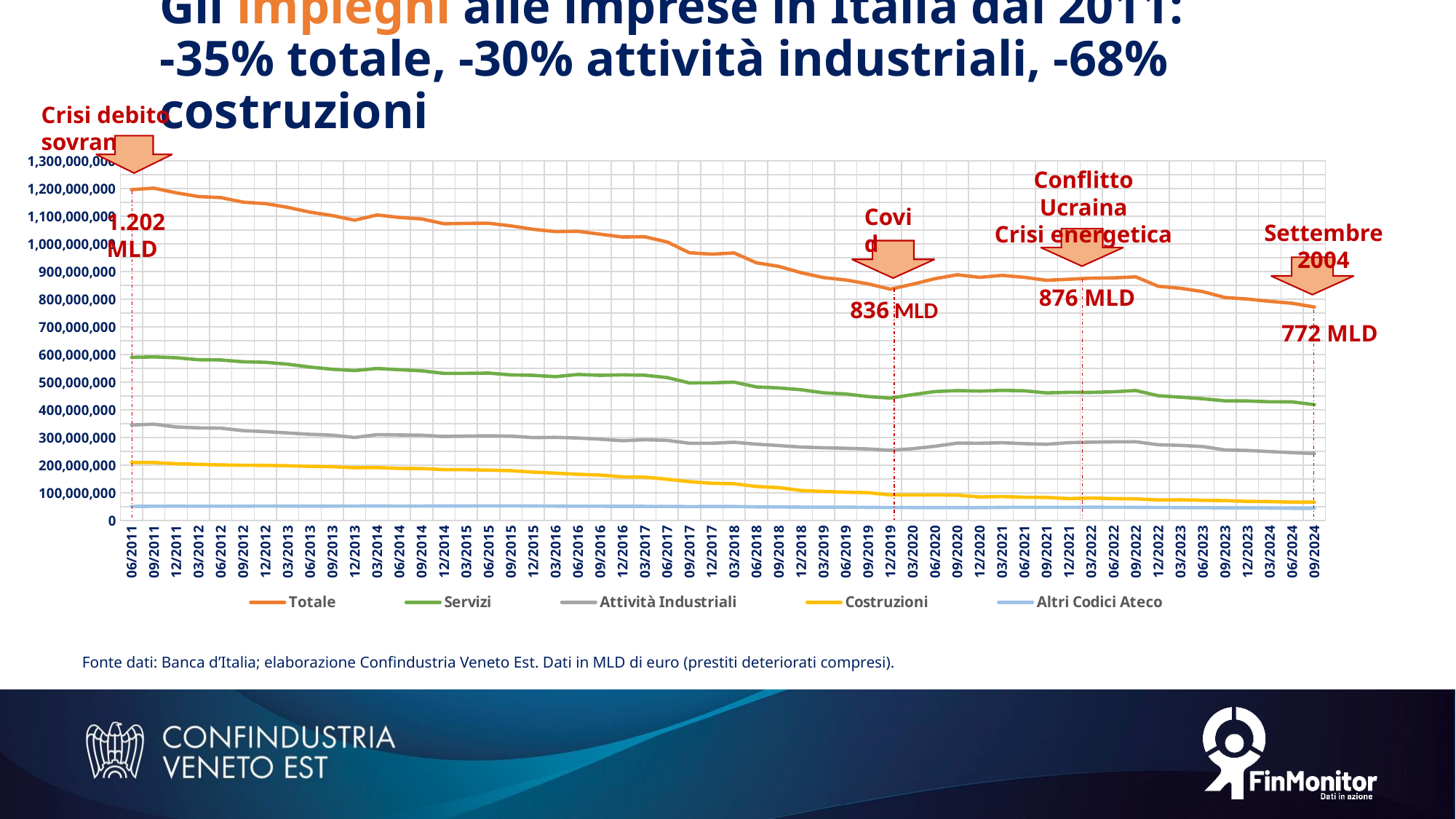
What value is labelled for the Totale series at 09/2024? 772 MLD What kind of chart is shown on the slide? line chart Is the value for Costruzioni at 09/2024 greater or less than 100,000,000? less How many series does the legend list? 5 Does the Totale series rise or fall from 06/2011 to 09/2024? fall Which series is drawn in orange? Totale Is the value for Servizi at 06/2011 greater or less than 500,000,000? greater What value is labelled for the Totale series at 03/2022? 876 MLD What value is labelled for the Totale series at 12/2019? 836 MLD What value is labelled for the Totale series at 06/2011? 1.202 MLD Which series has the lowest values across the whole period? Altri Codici Ateco What is the difference between the labelled Totale values at 06/2011 and 09/2024? 430 MLD